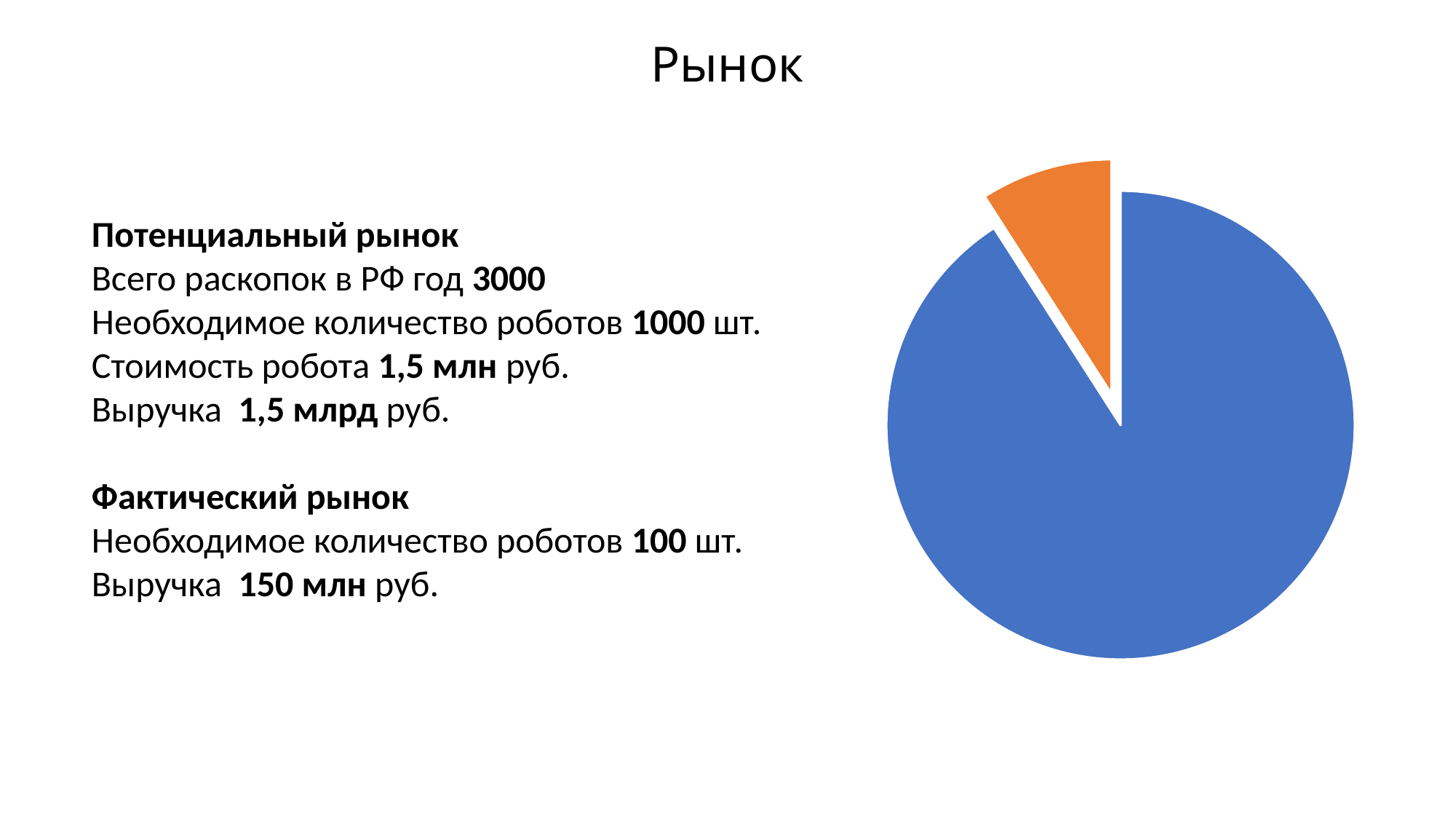
Which slice is larger in the pie chart, the blue one or the orange one? the blue one How many slices does the pie chart have? 2 Which slice of the pie chart is the smallest? the orange slice Which slice of the pie chart is the largest? the blue slice Does the blue slice take up more or less than half of the pie? more What kind of chart is shown on the slide? pie chart Which slice of the pie chart is pulled out (exploded) from the rest of the pie? the orange slice Does the pie chart display a legend? No Does the orange slice take up more or less than half of the pie? less